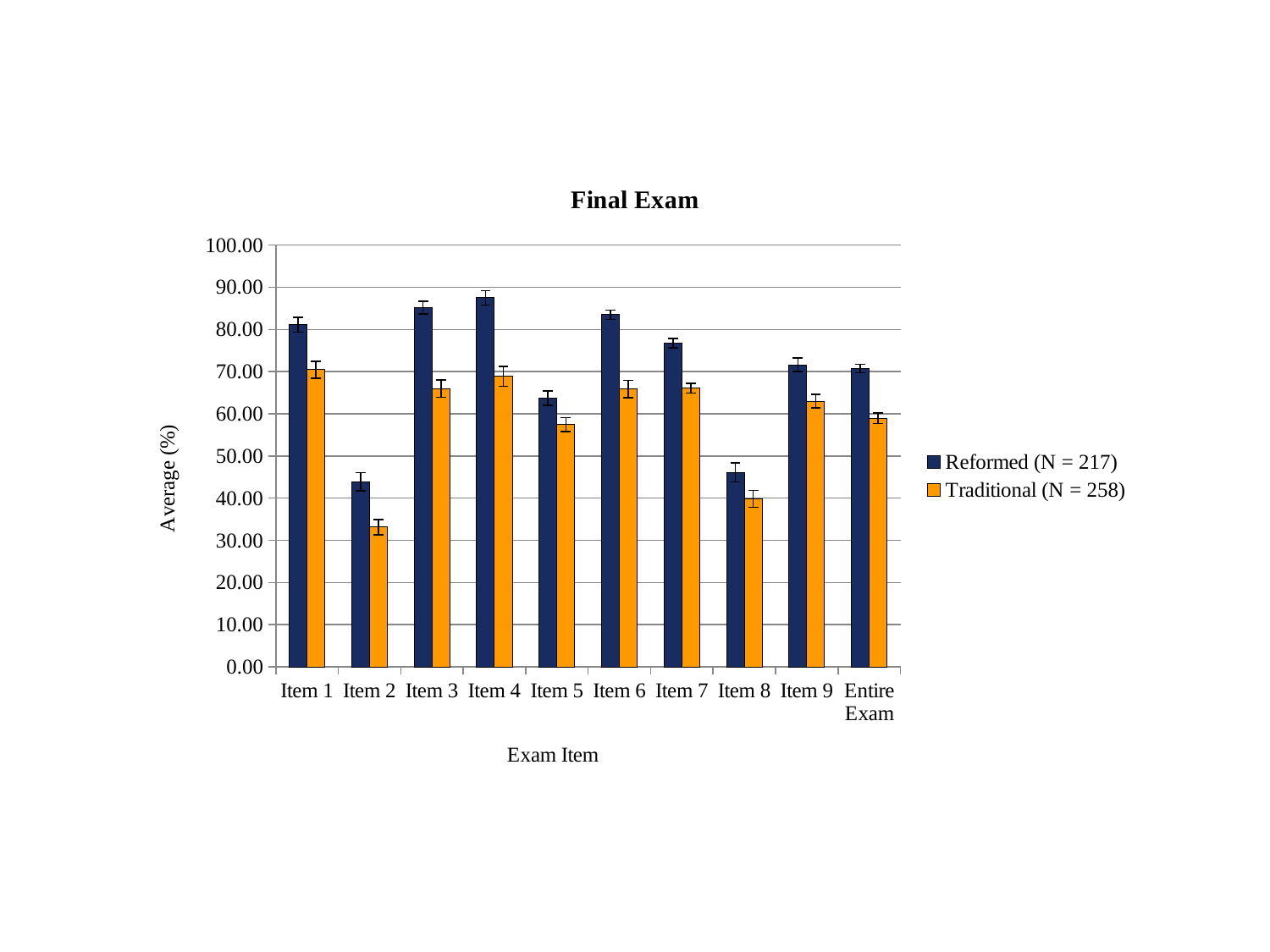
Is the Traditional (N = 258) value for Item 2 greater or less than 30.00? greater For Item 1, which series has the larger value, Reformed (N = 217) or Traditional (N = 258)? Reformed (N = 217) Is the Traditional (N = 258) value for Item 8 greater or less than 50.00? less Which exam item has the lowest value for Traditional (N = 258)? Item 2 What kind of chart is shown on the slide? bar chart Is the Reformed (N = 217) value for Item 2 greater or less than 50.00? less How many categories are shown on the x axis? 10 Which exam item has the highest value for Reformed (N = 217)? Item 4 What is the title of the chart? Final Exam What is the label on the vertical axis? Average (%) How many series does the legend list? 2